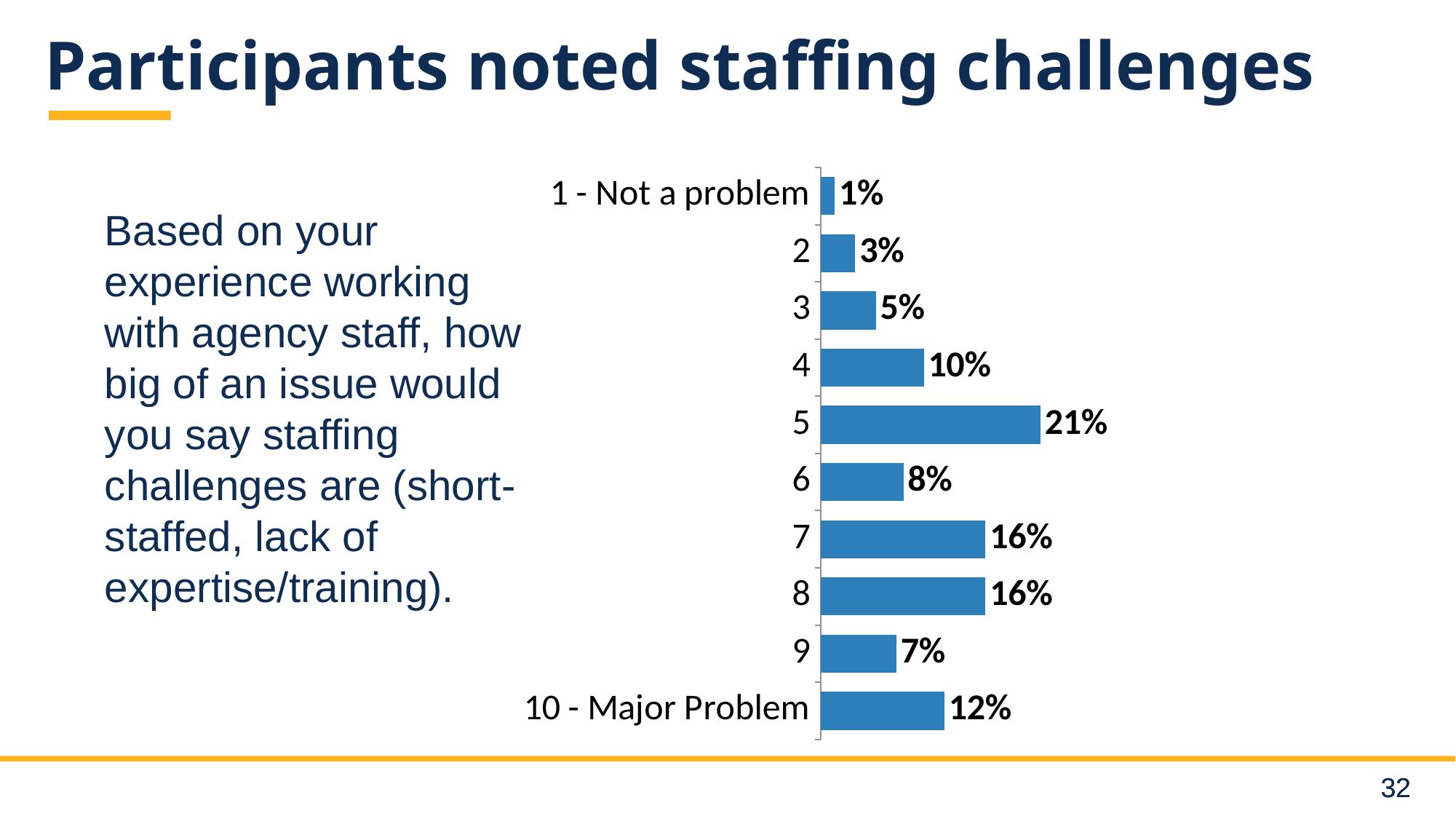
Which rating category has the highest percentage? 5 What percentage of participants rated staffing challenges as 5? 21% How many rating categories are shown in the chart? 10 What percentage of participants chose '10 - Major Problem'? 12% Which is larger, the percentage for rating 9 or the percentage for rating 6? 6 What colour are the bars in the chart? Blue What is the combined percentage for ratings 7 and 8? 32% Which rating category has the lowest percentage? 1 - Not a problem What percentage of participants chose '1 - Not a problem'? 1% What kind of chart is shown on the slide? Bar chart What is the difference between the percentage for rating 5 and the percentage for rating 4? 11% What percentage of participants rated staffing challenges as 3? 5%